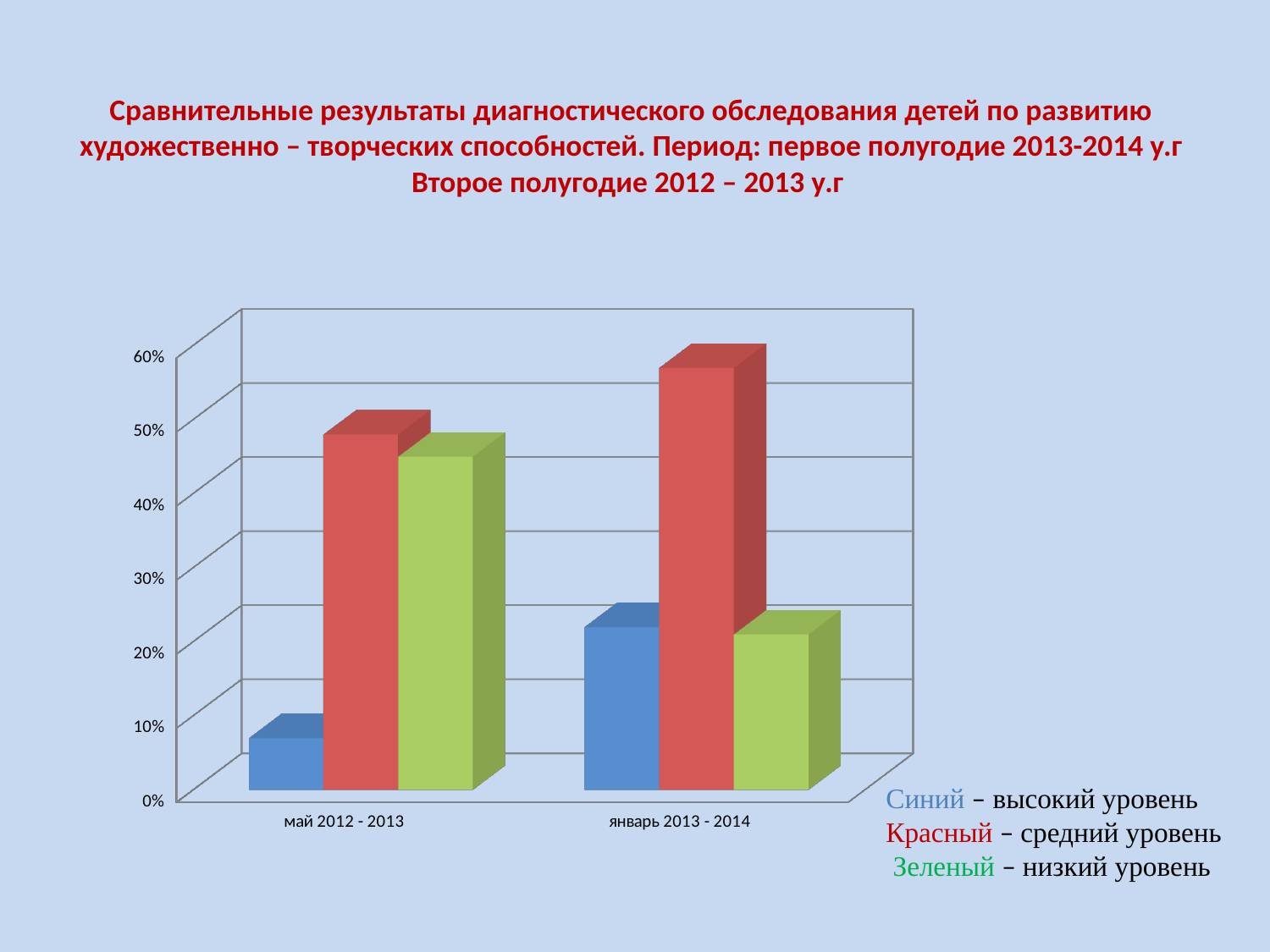
What kind of chart is shown on the slide? bar chart Does the green (низкий уровень) series rise or fall from "май 2012 - 2013" to "январь 2013 - 2014"? fall According to the slide, which level does the blue colour represent? высокий уровень Which series has the lowest bar for "май 2012 - 2013"? Синий (высокий уровень) Is the red bar for "январь 2013 - 2014" greater or less than 50%? greater Is the blue bar for "май 2012 - 2013" greater or less than 10%? less How many categories are shown on the x axis of the chart? 2 Is the green bar for "май 2012 - 2013" greater or less than 40%? greater Which is larger: the blue bar for "май 2012 - 2013" or the blue bar for "январь 2013 - 2014"? январь 2013 - 2014 How many coloured series (bars per category) does the chart show? 3 Which series has the highest bar for "январь 2013 - 2014"? Красный (средний уровень)